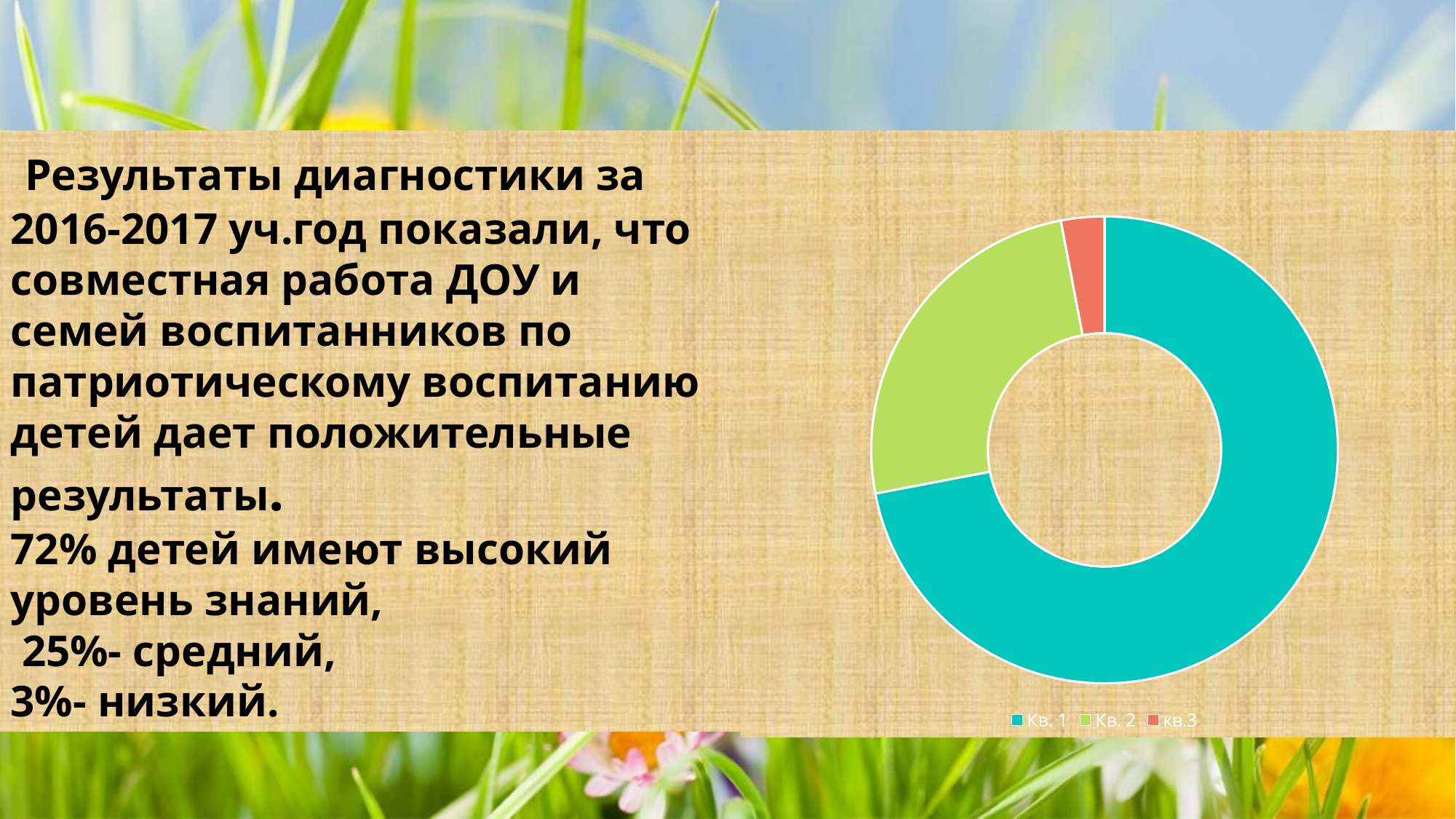
How many slices does the doughnut chart have? 3 How many entries does the chart legend list? 3 What colour is the slice for кв.3 in the chart? Red Does the largest slice of the doughnut chart take up more or less than half of the ring? More What colour is the slice for Кв. 1 in the chart? Teal What kind of chart is shown on the slide? Doughnut (pie) chart Which category has the largest slice in the doughnut chart? Кв. 1 Which category has the smallest slice in the doughnut chart? кв.3 Which slice is larger, Кв. 1 or Кв. 2? Кв. 1 Which slice is larger, Кв. 2 or кв.3? Кв. 2